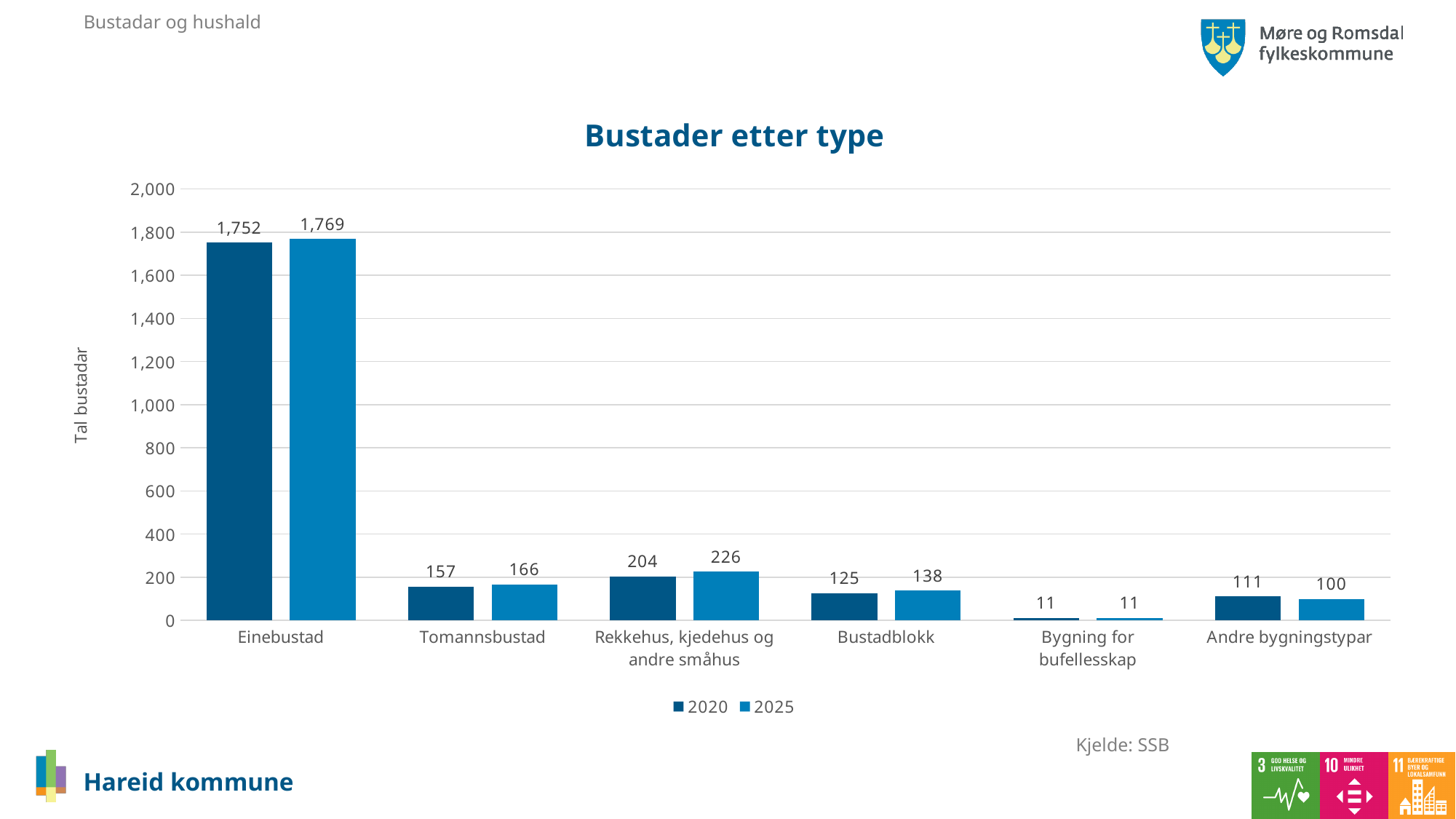
What kind of chart is this? Bar chart Which category has the lowest value in 2025? Bygning for bufellesskap What is the title of the chart? Bustader etter type How many categories are shown on the x axis? 6 What is the value for Einebustad in 2025? 1,769 Which is larger for Andre bygningstypar: the 2020 value or the 2025 value? 2020 What is the difference between the 2025 and 2020 values for Rekkehus, kjedehus og andre småhus? 22 How many series does the legend list? 2 What is the value for Tomannsbustad in 2020? 157 What is the value for Bustadblokk in 2025? 138 What is the value for Andre bygningstypar in 2020? 111 Which category has the highest value in 2020? Einebustad